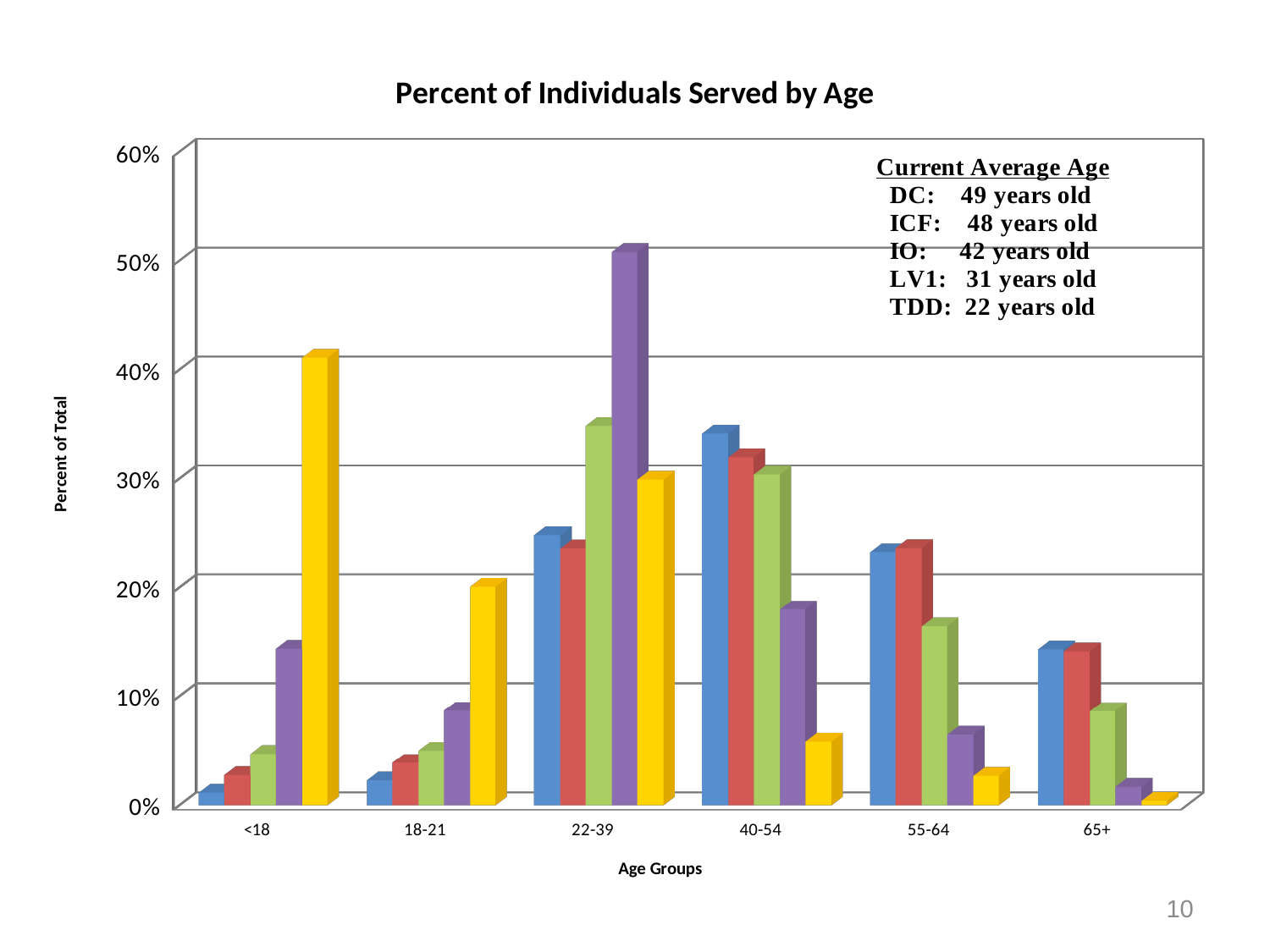
Is the value of the purple bar for the 22-39 age group greater or less than 40%? greater Is the value of the yellow bar for the <18 age group greater or less than 30%? greater Is the value of the yellow bar for the 65+ age group greater or less than 10%? less How many age groups are shown on the x axis? 6 In the 22-39 age group, which is larger, the purple bar or the green bar? purple bar What is the label on the y axis? Percent of Total In which age group is the yellow bar the tallest? <18 What kind of chart is shown on the slide? bar chart In which age group is the purple bar the tallest? 22-39 How many bars are plotted for each age group? 5 What is the title of the chart? Percent of Individuals Served by Age